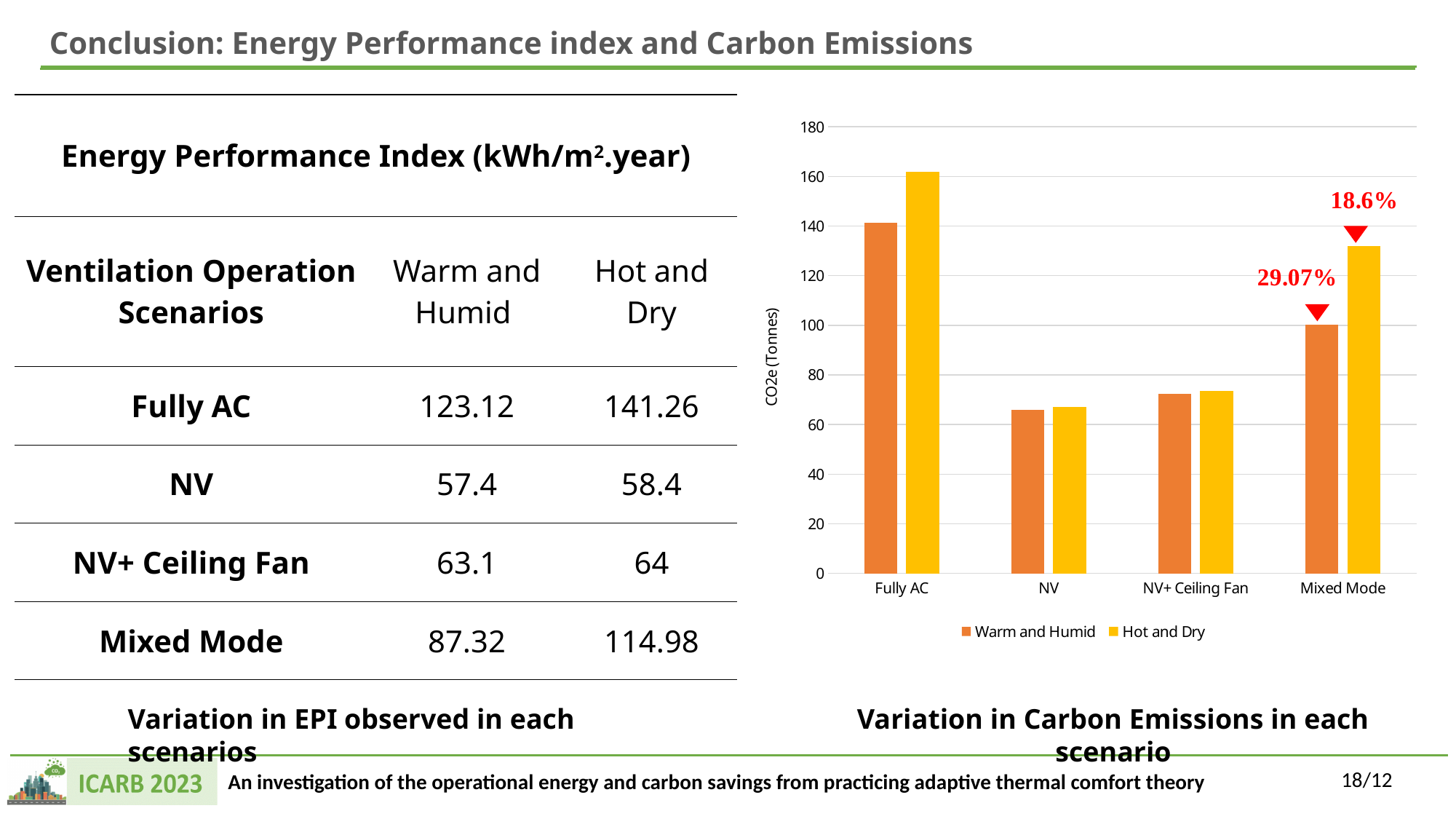
In the carbon emissions chart, is the Warm and Humid value for NV greater or less than 80? less In the carbon emissions chart, is the Hot and Dry value for Mixed Mode greater or less than 120? greater In the carbon emissions chart, is the Hot and Dry value for Fully AC greater or less than 140? greater What is the y-axis label of the carbon emissions chart? CO2e (Tonnes) How many series does the legend of the carbon emissions chart list? 2 In the carbon emissions chart, which is larger: the Warm and Humid bar for Fully AC or the Warm and Humid bar for Mixed Mode? Fully AC How many ventilation scenarios are shown on the x axis of the carbon emissions chart? 4 What percentage is annotated above the Hot and Dry bar for Mixed Mode in the carbon emissions chart? 18.6% In the carbon emissions chart, which scenario has the highest Hot and Dry bar? Fully AC In the carbon emissions chart, which scenario has the lowest Warm and Humid bar? NV What kind of chart is shown on the slide? bar chart In the carbon emissions chart, for Mixed Mode, which series has the larger bar: Warm and Humid or Hot and Dry? Hot and Dry